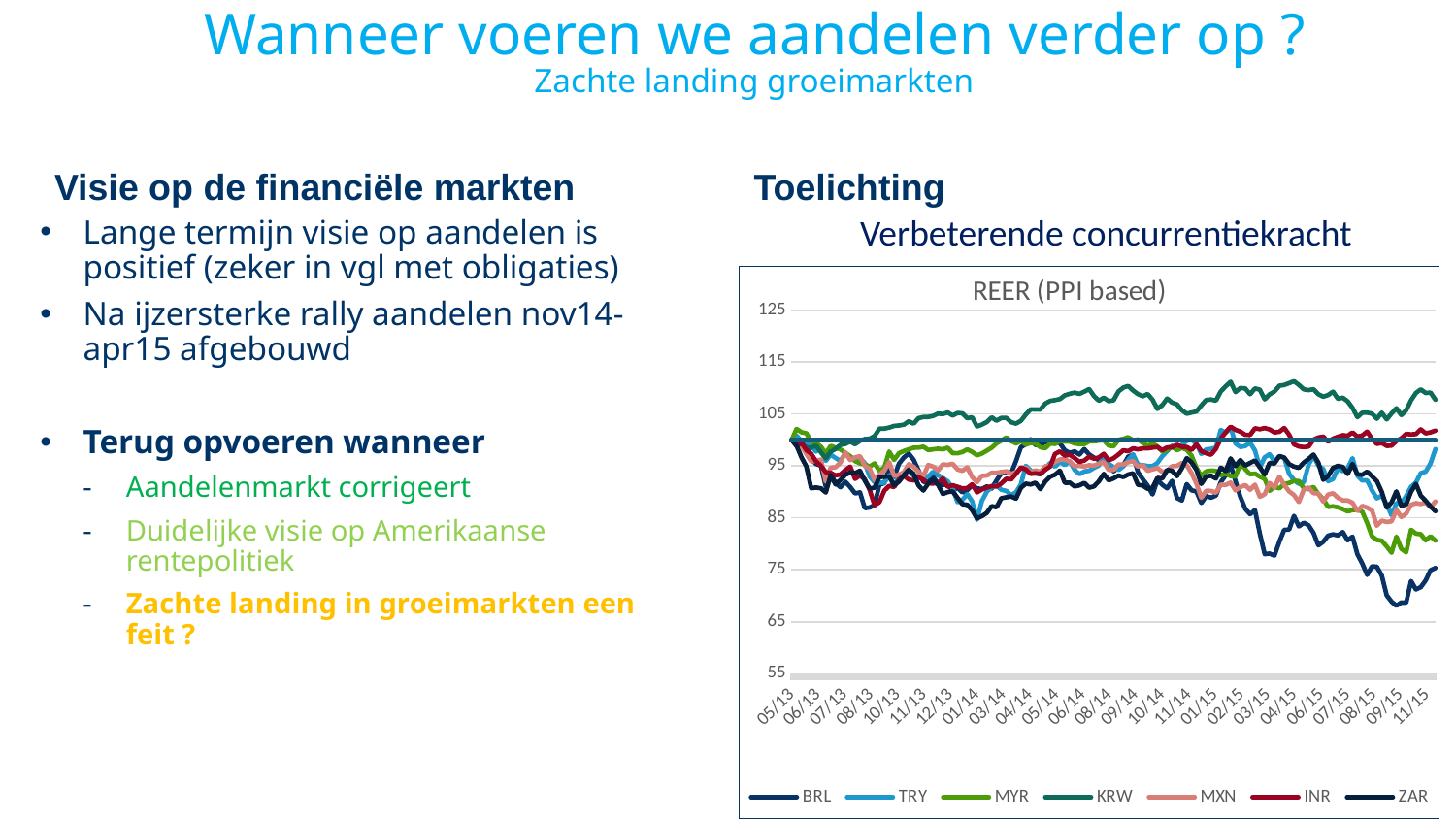
At 11/15, which is larger, the value for KRW or the value for MYR? KRW Is the lowest value reached by any series on the chart greater or less than 75? less Does the KRW series rise or fall overall from 05/13 to 11/15? rise Is the value for KRW at 11/15 greater or less than 105? greater Which series is the highest at the end of the chart (11/15)? KRW Is the value for MYR at 11/15 greater or less than 85? less What is the title of the chart? REER (PPI based) Does the MYR series rise or fall overall from 05/13 to 11/15? fall How many series does the chart legend list? 7 What is the first date label on the x axis? 05/13 What kind of chart is shown on the slide? line chart